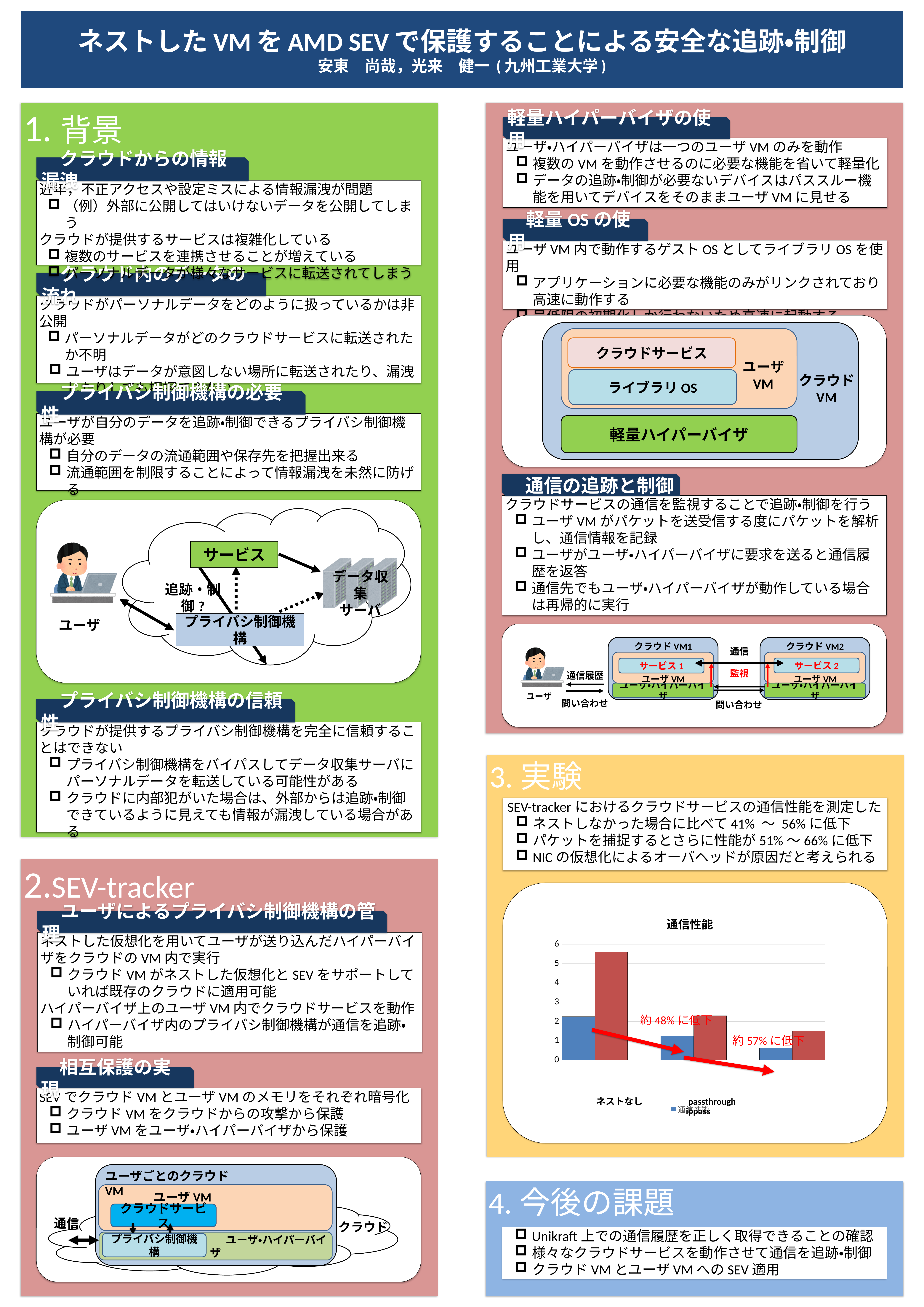
In the 通信性能 chart, which is larger: the red bar for ネストなし or the red bar for ippass? ネストなし In the 通信性能 chart, is the blue bar for ネストなし greater or less than 2? greater In the 通信性能 chart, which category has the tallest red bar? ネストなし In the 通信性能 chart, is the red bar for ネストなし greater or less than 5? greater In the 通信性能 chart, which category has the shortest blue bar? ippass In the 通信性能 chart, do the blue bars rise or fall from ネストなし to ippass? fall What is the title of the chart in section 3. 実験? 通信性能 What kind of chart is shown in the 通信性能 chart? bar chart In the 通信性能 chart, is the red bar for passthrough greater or less than 2? greater How many categories are shown on the x axis of the 通信性能 chart? 3 What is the highest value shown on the y axis of the 通信性能 chart? 6